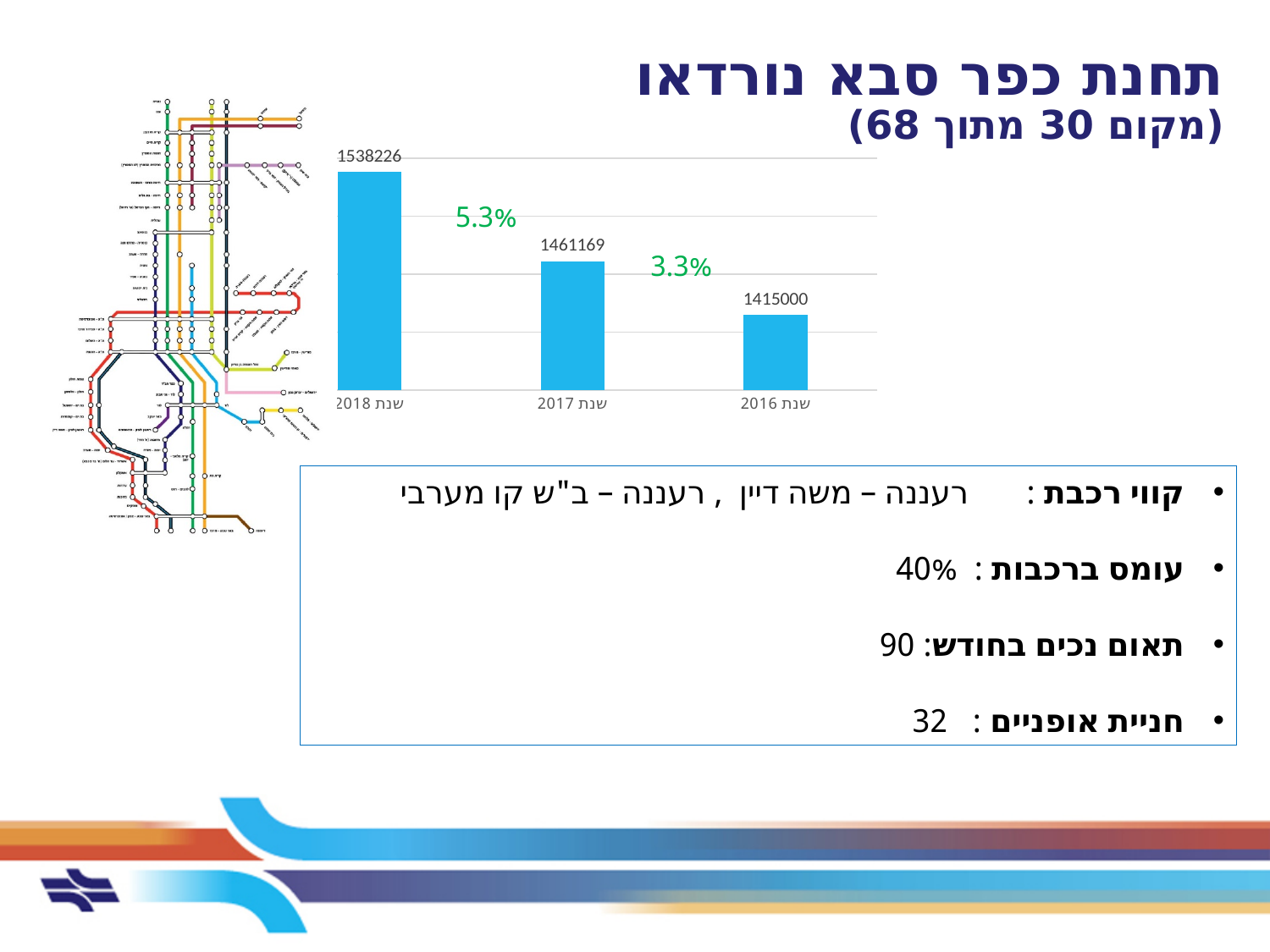
Which year has the highest value? שנת 2018 What is the value for שנת 2016? 1415000 Which year has the lowest value? שנת 2016 How many bars are shown in the chart? 3 Which is larger, the value for שנת 2017 or the value for שנת 2016? שנת 2017 What kind of chart is shown on the slide? bar chart What is the difference between the values for שנת 2017 and שנת 2016? 46169 What is the value for שנת 2018? 1538226 What is the difference between the values for שנת 2018 and שנת 2017? 77057 What percentage label is shown between the bars for שנת 2018 and שנת 2017? 5.3% Do the values rise or fall from שנת 2016 to שנת 2018? rise What is the value for שנת 2017? 1461169